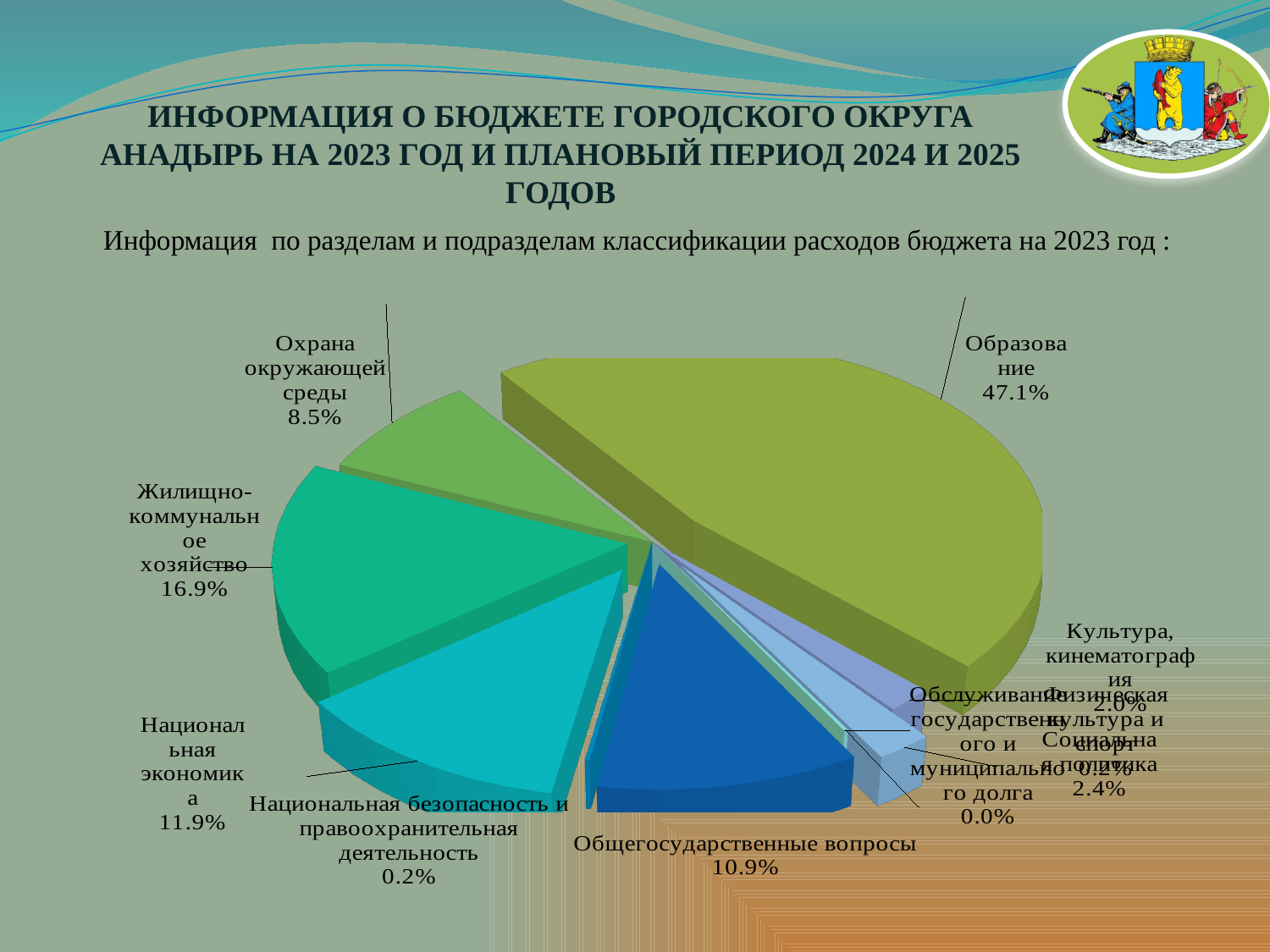
What percentage is shown for Жилищно-коммунальное хозяйство? 16.9% What percentage is shown for Общегосударственные вопросы? 10.9% By how many percentage points does the share of Образование exceed the share of Жилищно-коммунальное хозяйство? 30.2 What share of the 2023 budget expenditures goes to Образование? 47.1% What percentage is shown for Национальная безопасность и правоохранительная деятельность? 0.2% Which has a larger share: Национальная экономика or Общегосударственные вопросы? Национальная экономика Which section has the largest share of the budget expenditures? Образование What percentage is shown for Охрана окружающей среды? 8.5% What kind of chart is shown on the slide? Pie chart For which year does the chart show the breakdown of budget expenditures by section? 2023 What percentage is shown for Обслуживание государственного и муниципального долга? 0.0% What percentage is shown for Национальная экономика? 11.9%